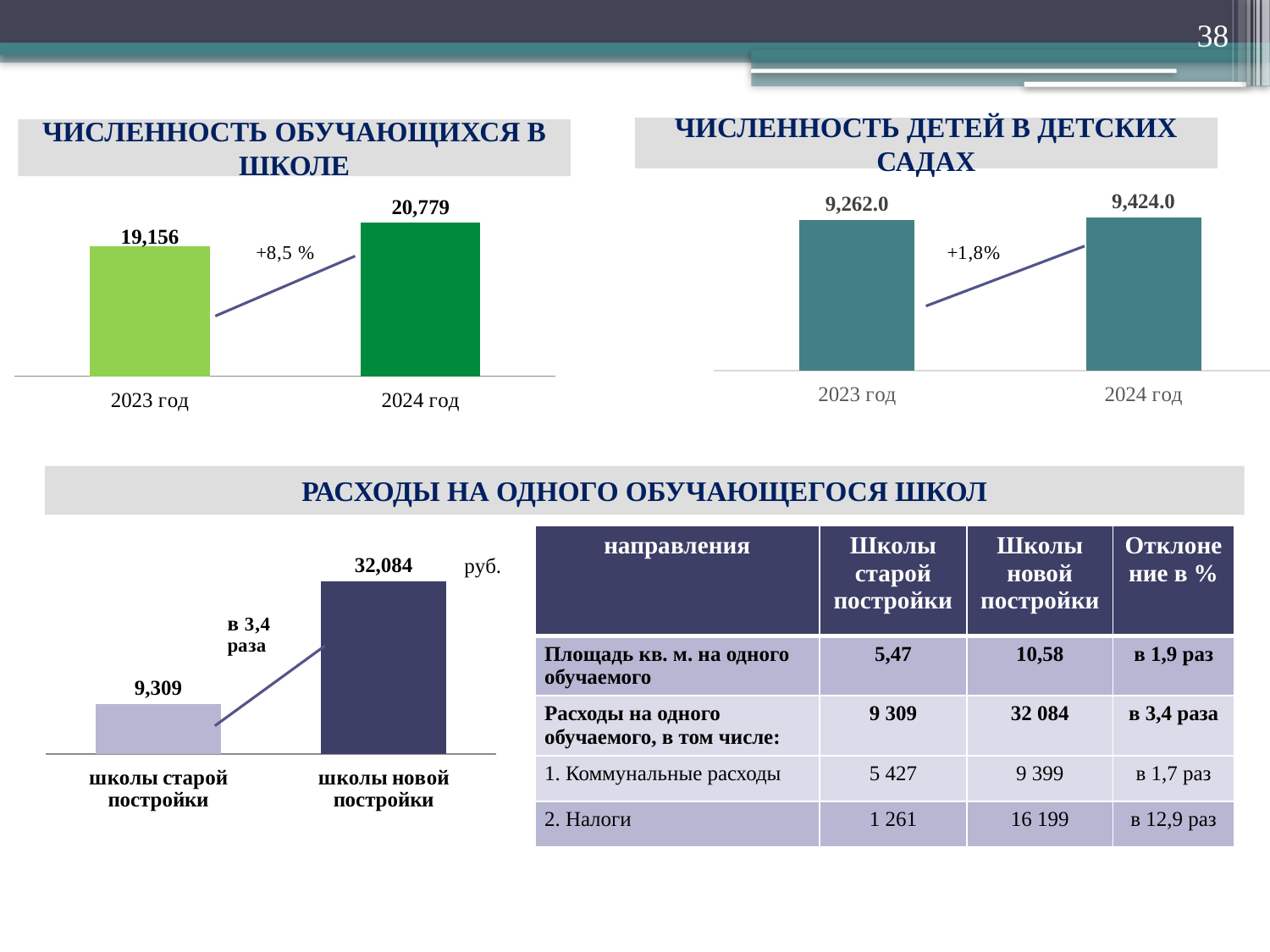
What kind of chart is the one titled "РАСХОДЫ НА ОДНОГО ОБУЧАЮЩЕГОСЯ ШКОЛ"? bar chart In the chart titled "ЧИСЛЕННОСТЬ ДЕТЕЙ В ДЕТСКИХ САДАХ", do the values rise or fall from 2023 год to 2024 год? rise In the chart titled "ЧИСЛЕННОСТЬ ОБУЧАЮЩИХСЯ В ШКОЛЕ", what is the value for 2023 год? 19,156 In the chart titled "РАСХОДЫ НА ОДНОГО ОБУЧАЮЩЕГОСЯ ШКОЛ", what is the difference between the values for школы новой постройки and школы старой постройки? 22,775 In the chart titled "ЧИСЛЕННОСТЬ ОБУЧАЮЩИХСЯ В ШКОЛЕ", what is the difference between the 2024 год and 2023 год values? 1,623 In the chart titled "ЧИСЛЕННОСТЬ ДЕТЕЙ В ДЕТСКИХ САДАХ", which year has the higher value? 2024 год In the chart titled "РАСХОДЫ НА ОДНОГО ОБУЧАЮЩЕГОСЯ ШКОЛ", which category has the lowest value? школы старой постройки In the chart titled "ЧИСЛЕННОСТЬ ДЕТЕЙ В ДЕТСКИХ САДАХ", what is the value for 2023 год? 9,262.0 In the chart titled "ЧИСЛЕННОСТЬ ОБУЧАЮЩИХСЯ В ШКОЛЕ", what is the value for 2024 год? 20,779 In the chart titled "ЧИСЛЕННОСТЬ ОБУЧАЮЩИХСЯ В ШКОЛЕ", what percentage change is shown between 2023 год and 2024 год? +8,5 % In the chart titled "ЧИСЛЕННОСТЬ ДЕТЕЙ В ДЕТСКИХ САДАХ", what is the difference between the 2024 год and 2023 год values? 162.0 In the chart titled "РАСХОДЫ НА ОДНОГО ОБУЧАЮЩЕГОСЯ ШКОЛ", what is the value for школы новой постройки? 32,084